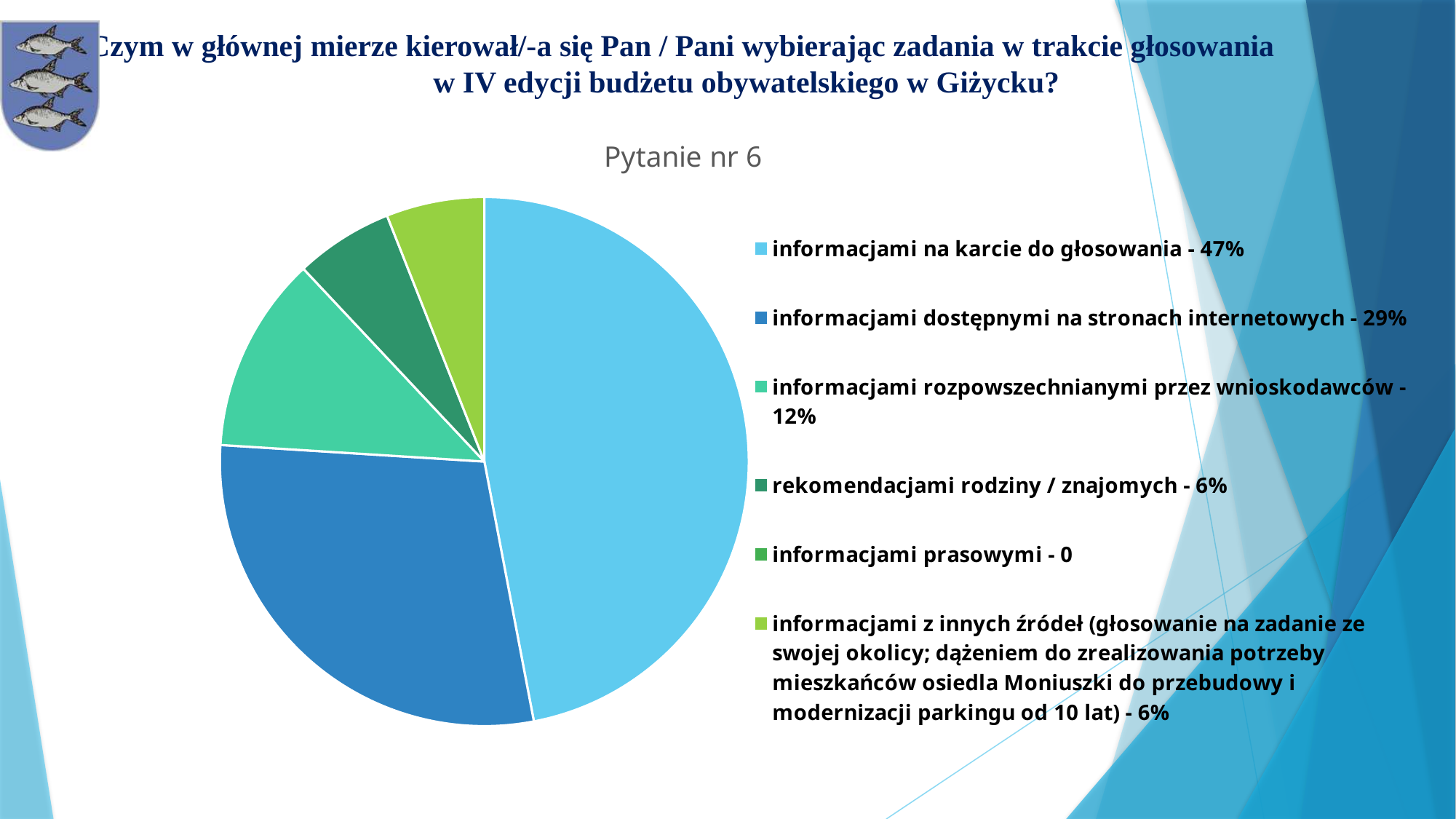
What is the title of the chart? Pytanie nr 6 What is the difference between the share for 'informacjami na karcie do głosowania' and 'informacjami dostępnymi na stronach internetowych'? 18% What value is given for 'informacjami prasowymi'? 0 What share of responses is 'informacjami na karcie do głosowania'? 47% What share of responses is 'informacjami dostępnymi na stronach internetowych'? 29% What share of responses is 'informacjami rozpowszechnianymi przez wnioskodawców'? 12% What type of chart is shown on the slide? pie chart Which category has the largest share of the pie? informacjami na karcie do głosowania - 47% Which category has the smallest value in the legend? informacjami prasowymi - 0 What share of responses is 'rekomendacjami rodziny / znajomych'? 6% Which is larger: the share for 'informacjami rozpowszechnianymi przez wnioskodawców' or for 'rekomendacjami rodziny / znajomych'? informacjami rozpowszechnianymi przez wnioskodawców How many categories does the legend list? 6